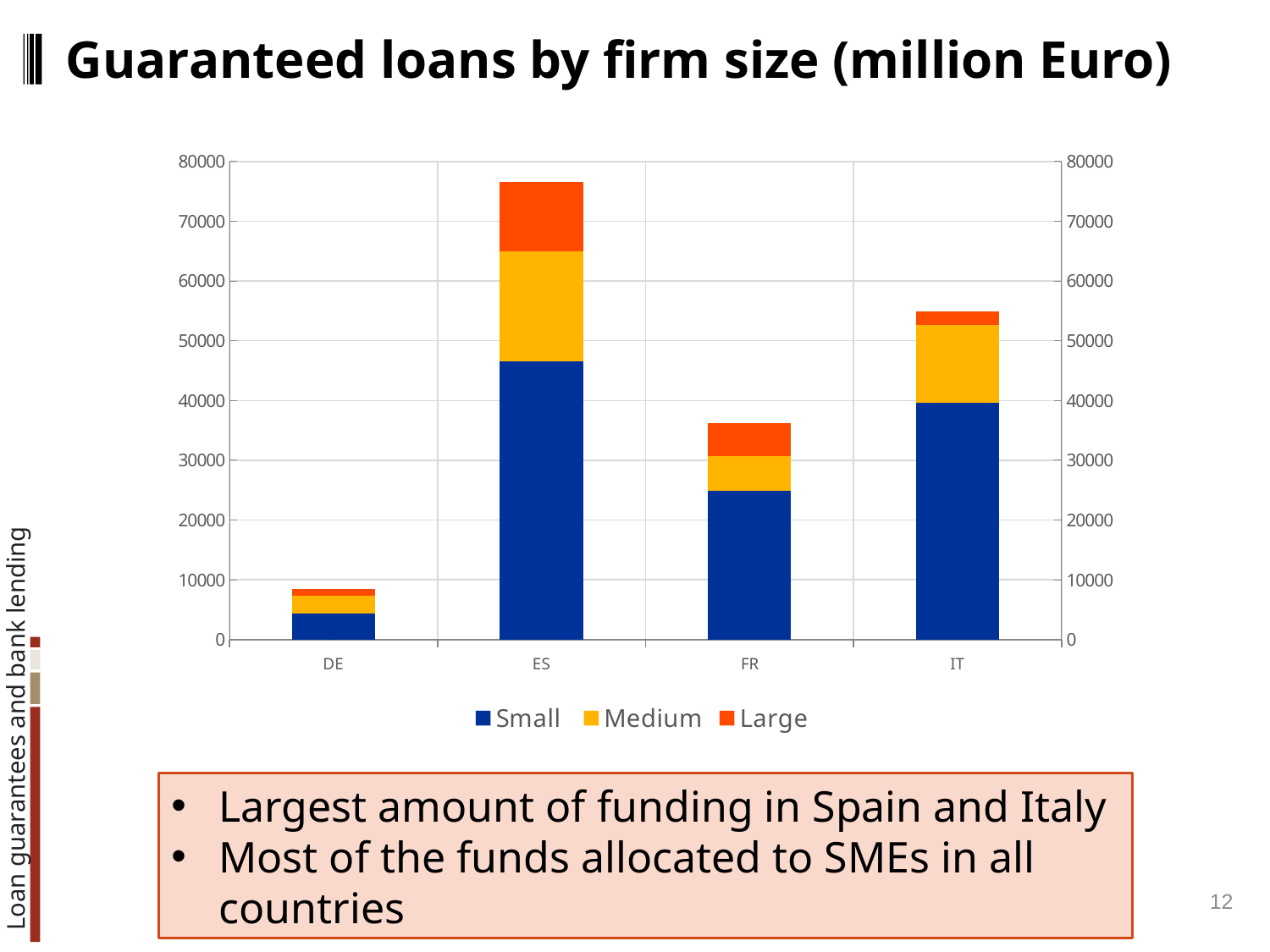
What is the title of the chart on the slide? Guaranteed loans by firm size (million Euro) Is the total stacked bar for ES greater or less than 70000? greater Is the total stacked bar for DE greater or less than 10000? less Which series is shown in dark blue in the chart's legend? Small How many series does the chart's legend list? 3 Which country has the tallest stacked bar in the chart? ES What kind of chart is shown on the slide? Stacked bar chart Which country has the shortest stacked bar in the chart? DE How many countries are shown on the x axis of the chart? 4 Is the total stacked bar for IT greater or less than 50000? greater Which country has a larger total of guaranteed loans, ES or FR? ES